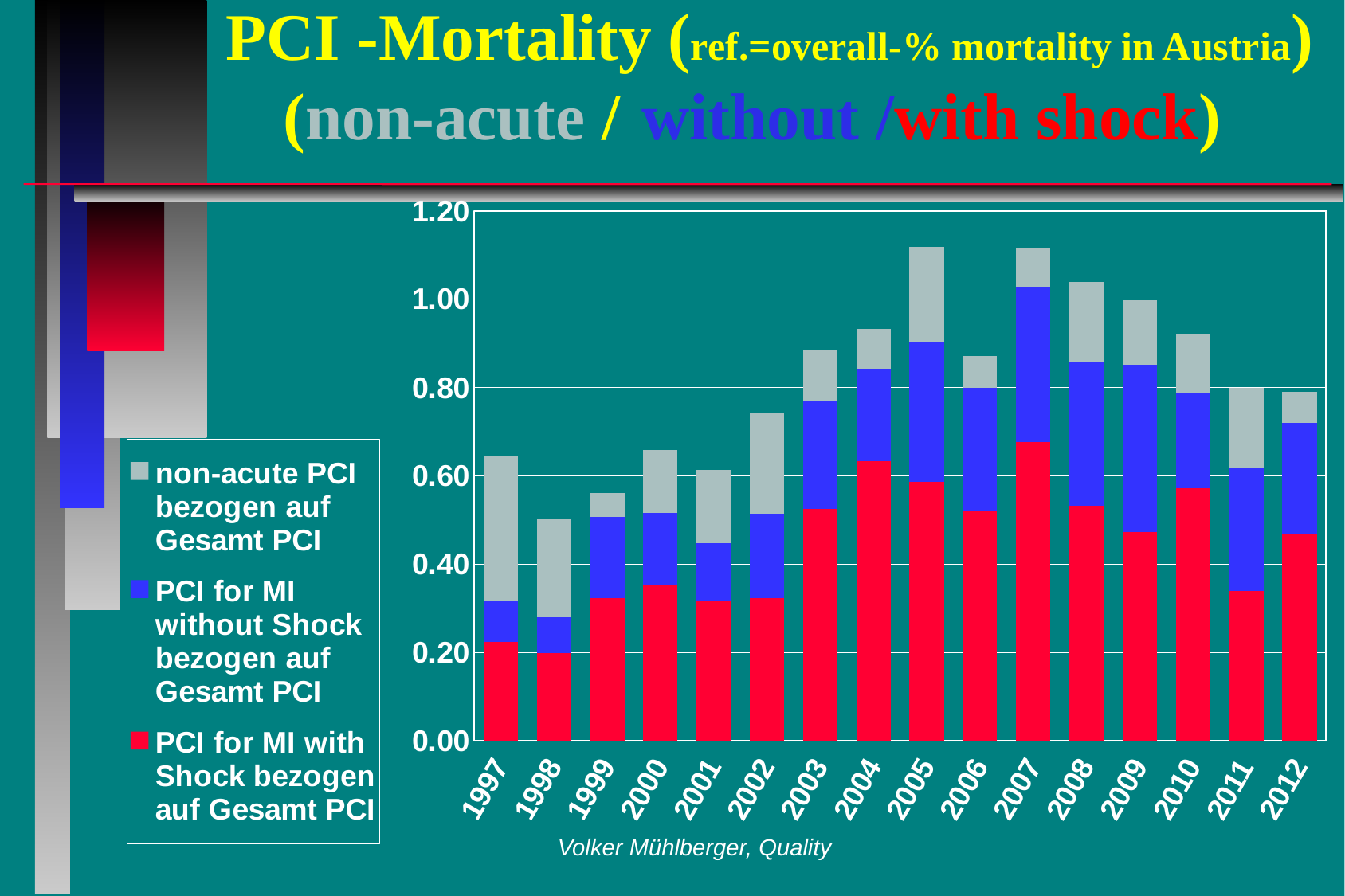
Is the 'PCI for MI with Shock' segment for 2000 greater or less than 0.40? less What kind of chart is shown on the slide? Stacked bar chart Which year has the larger total stacked bar, 1999 or 2000? 2000 Is the total stacked value for 1997 greater or less than 0.60? greater Is the total stacked value for 1998 greater or less than 0.60? less How many years are shown along the x axis of the chart? 16 How many series does the legend list? 3 Which year has the lowest total stacked bar? 1998 Which colour represents 'PCI for MI with Shock bezogen auf Gesamt PCI' in the legend? Red Do the total stacked values generally rise or fall from 2007 to 2012? fall